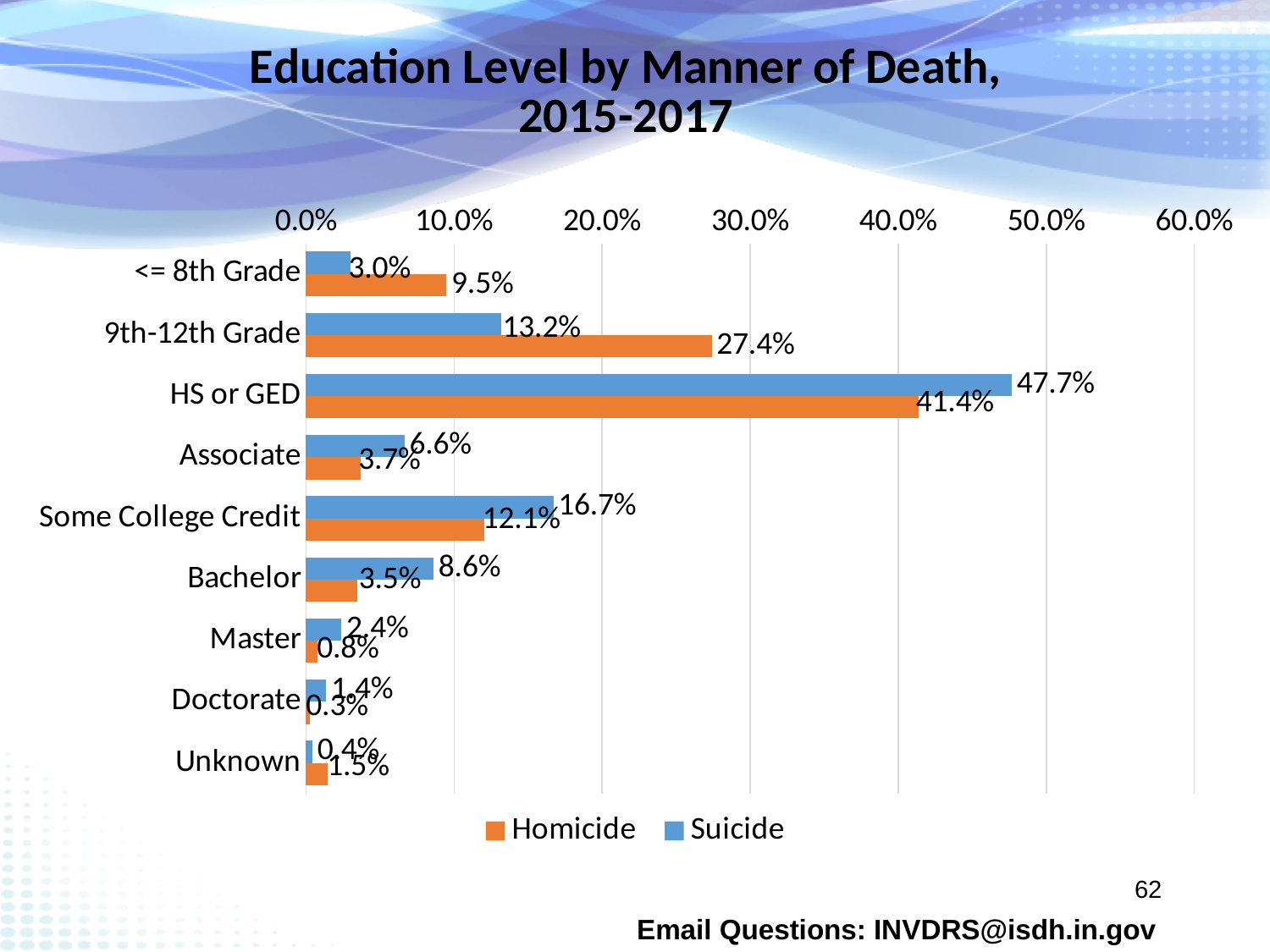
How many education level categories are shown on the chart? 9 What is the difference between the Homicide and Suicide values for 9th-12th Grade? 14.2% What is the Suicide value for HS or GED? 47.7% Which education level has the highest Suicide value? HS or GED How many series does the legend list? 2 Is the Homicide value for HS or GED greater or less than 40.0%? greater What is the Homicide value for 9th-12th Grade? 27.4% What kind of chart is shown on the slide? Bar chart Which education level has the lowest Homicide value? Doctorate What is the Homicide value for Doctorate? 0.3% Which colour represents the Homicide series in the chart? Orange For Bachelor, which is larger, the Homicide value or the Suicide value? Suicide